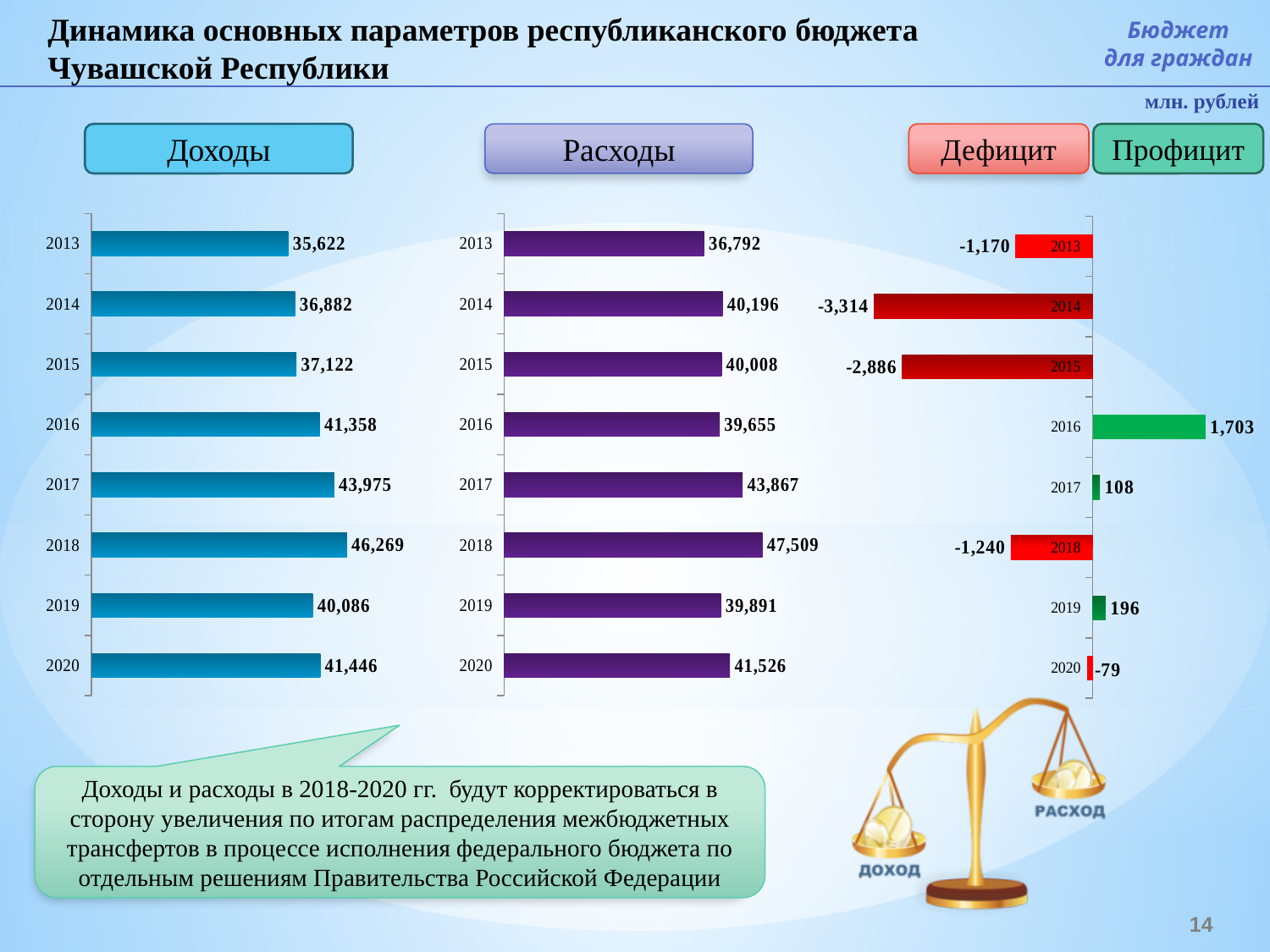
In the Доходы chart, which year has the larger value, 2019 or 2020? 2020 In the Доходы chart, do the values rise or fall from 2013 to 2018? rise What unit of measurement is stated for the charts on the slide? млн. рублей In the Расходы chart, what is the value for 2018? 47,509 In the Доходы chart, what is the value for 2017? 43,975 In the Доходы chart, what is the difference between the values for 2018 and 2017? 2,294 In the Доходы chart, which year has the highest value? 2018 How many years are shown in the Расходы chart? 8 In the Дефицит/Профицит chart, what is the value for 2014? -3,314 What type of chart is the Доходы chart? bar chart In the Дефицит/Профицит chart, which year has the largest surplus (highest positive value)? 2016 In the Расходы chart, which year has the lowest value? 2013